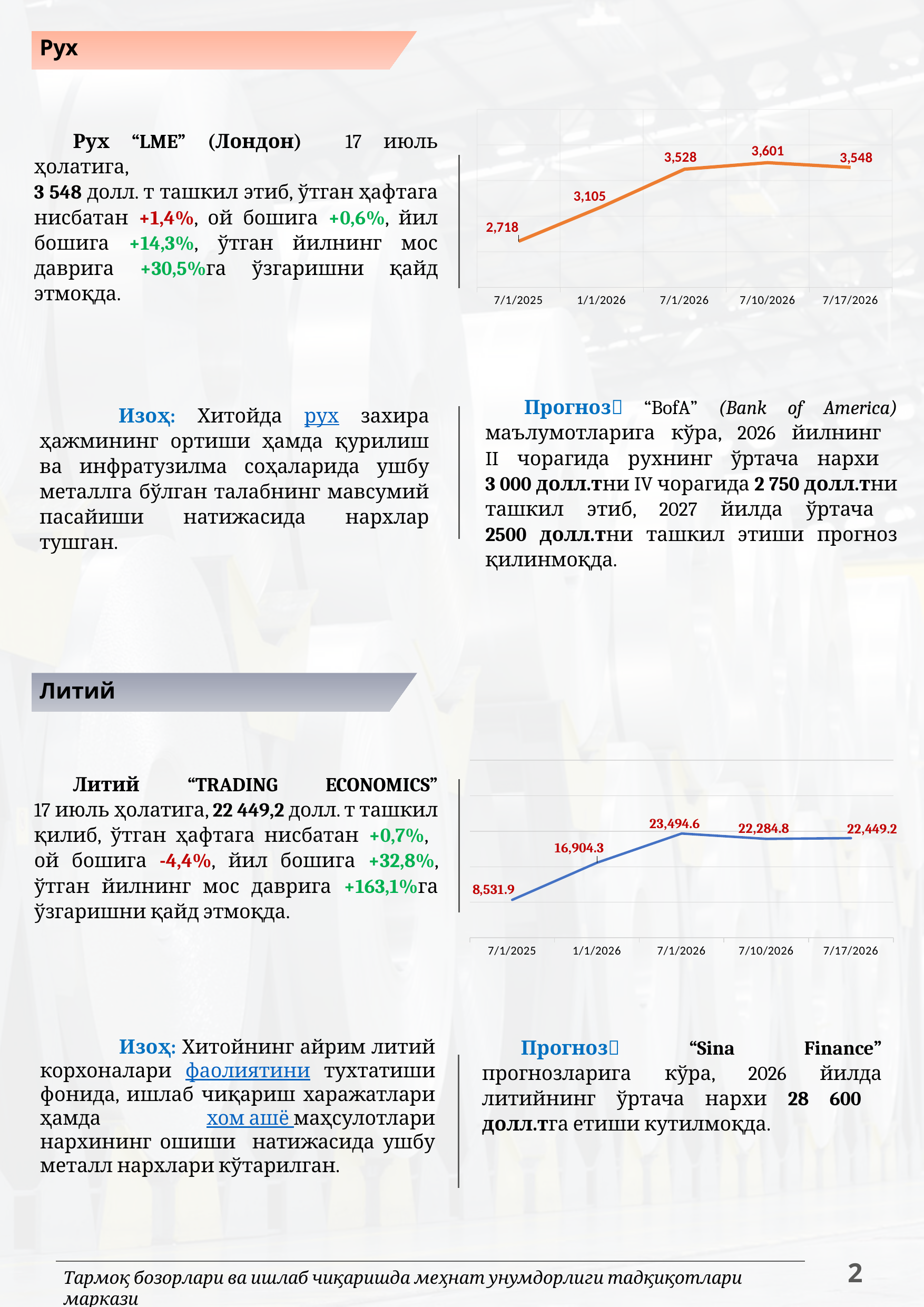
In the bottom chart (Литий section), what is the value for 1/1/2026? 16,904.3 In the top chart (Рух section), which date has the lowest value? 7/1/2025 What type of chart is the top chart (Рух section)? Line chart In the top chart (Рух section), what is the difference between the values for 7/10/2026 and 7/17/2026? 53 In the top chart (Рух section), what is the value for 7/17/2026? 3,548 In the bottom chart (Литий section), what is the value for 7/17/2026? 22,449.2 In the top chart (Рух section), how many data points are plotted? 5 In the bottom chart (Литий section), which date has the highest value? 7/1/2026 In the top chart (Рух section), what is the value for 7/1/2025? 2,718 In the bottom chart (Литий section), is the value for 7/1/2026 or 7/10/2026 larger? 7/1/2026 In the bottom chart (Литий section), what is the difference between the values for 1/1/2026 and 7/1/2025? 8,372.4 In the top chart (Рух section), which date has the highest value? 7/10/2026